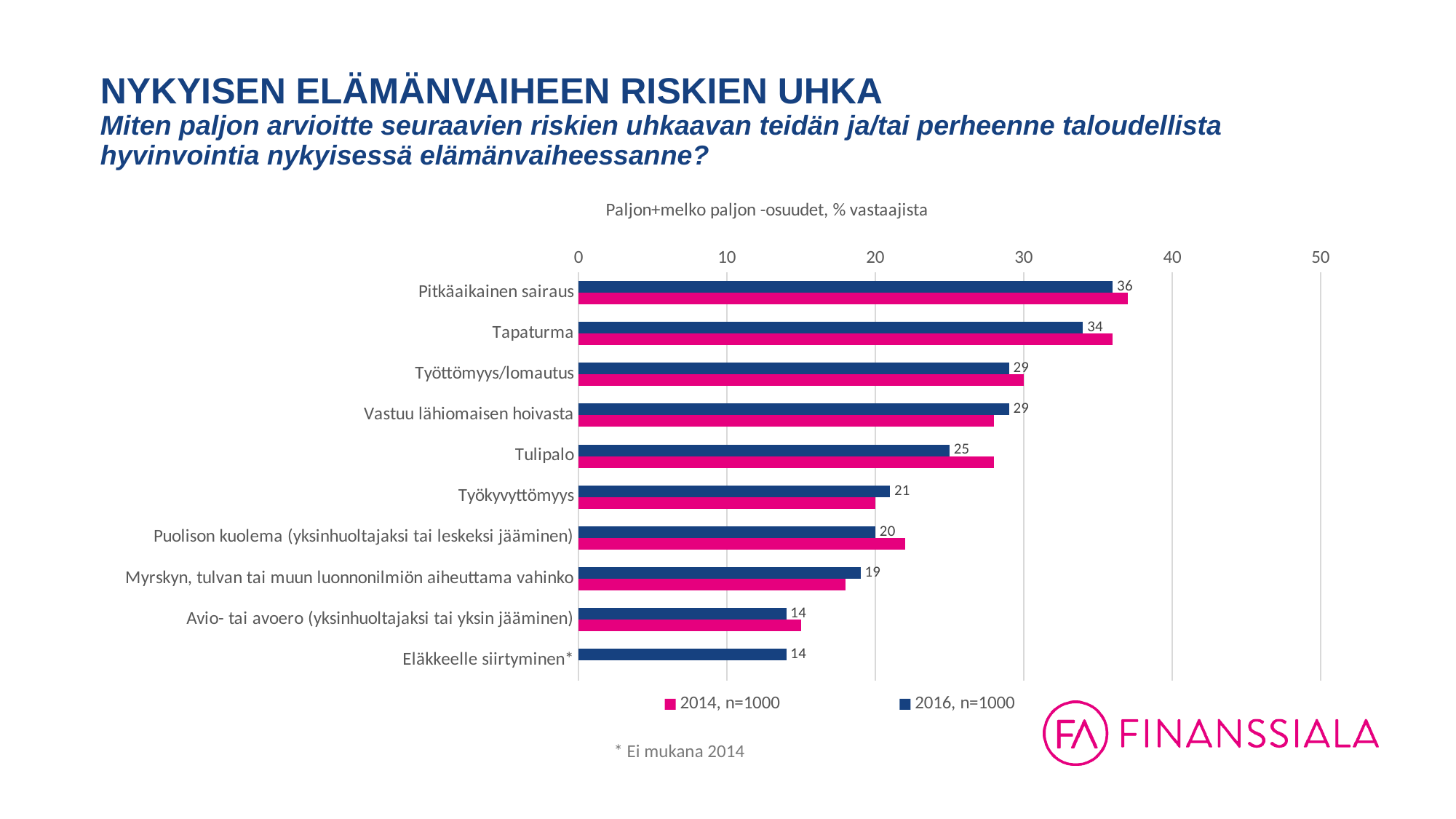
What is the 2016 value for Myrskyn, tulvan tai muun luonnonilmiön aiheuttama vahinko? 19 How many risk categories are plotted on the chart? 10 What is the difference between the 2016 values for Pitkäaikainen sairaus and Tapaturma? 2 What is the 2016 value for Tulipalo? 25 Which colour represents the 2016, n=1000 series? blue For Tulipalo, which series has the larger value, 2014 or 2016? 2014 How many series does the legend list? 2 What is the difference between the 2016 values for Pitkäaikainen sairaus and Eläkkeelle siirtyminen*? 22 Which category has the highest 2016 value? Pitkäaikainen sairaus What kind of chart is shown on the slide? bar chart What is the 2016 value for Tapaturma? 34 Is the 2014 value for Pitkäaikainen sairaus greater or less than 30? greater